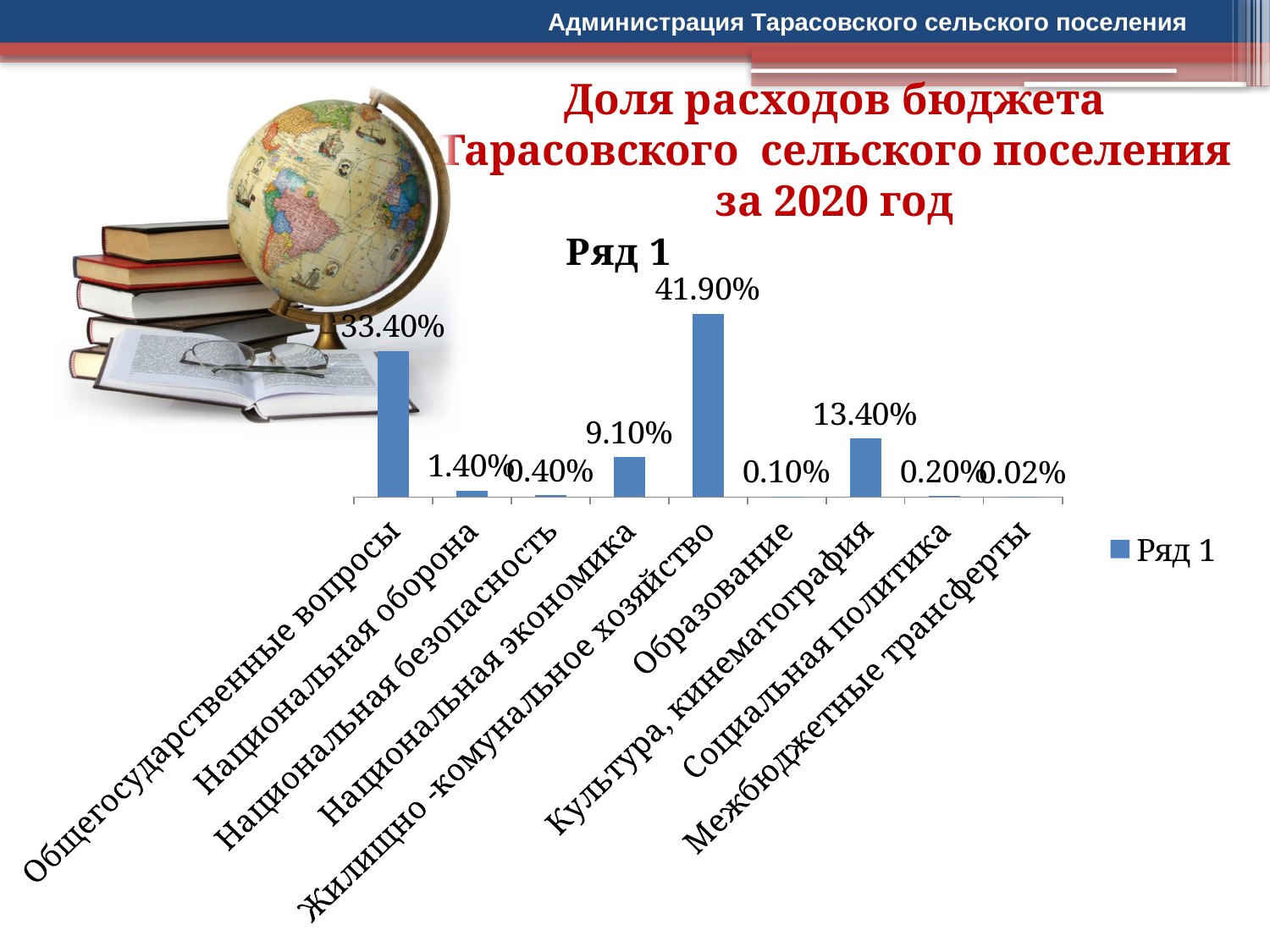
What is the value for Общегосударственные вопросы? 33.40% What is the name of the series shown in the legend? Ряд 1 What is the value for Жилищно-комунальное хозяйство? 41.90% How many series does the legend list? 1 What is the value for Межбюджетные трансферты? 0.02% Which category has the lowest value? Межбюджетные трансферты How many categories are shown on the x axis? 9 What is the value for Культура, кинематография? 13.40% Which is larger, the value for Национальная экономика or the value for Культура, кинематография? Культура, кинематография What kind of chart is shown on the slide? Bar chart Which category has the highest value? Жилищно-комунальное хозяйство What is the difference between the values for Жилищно-комунальное хозяйство and Общегосударственные вопросы? 8.50%